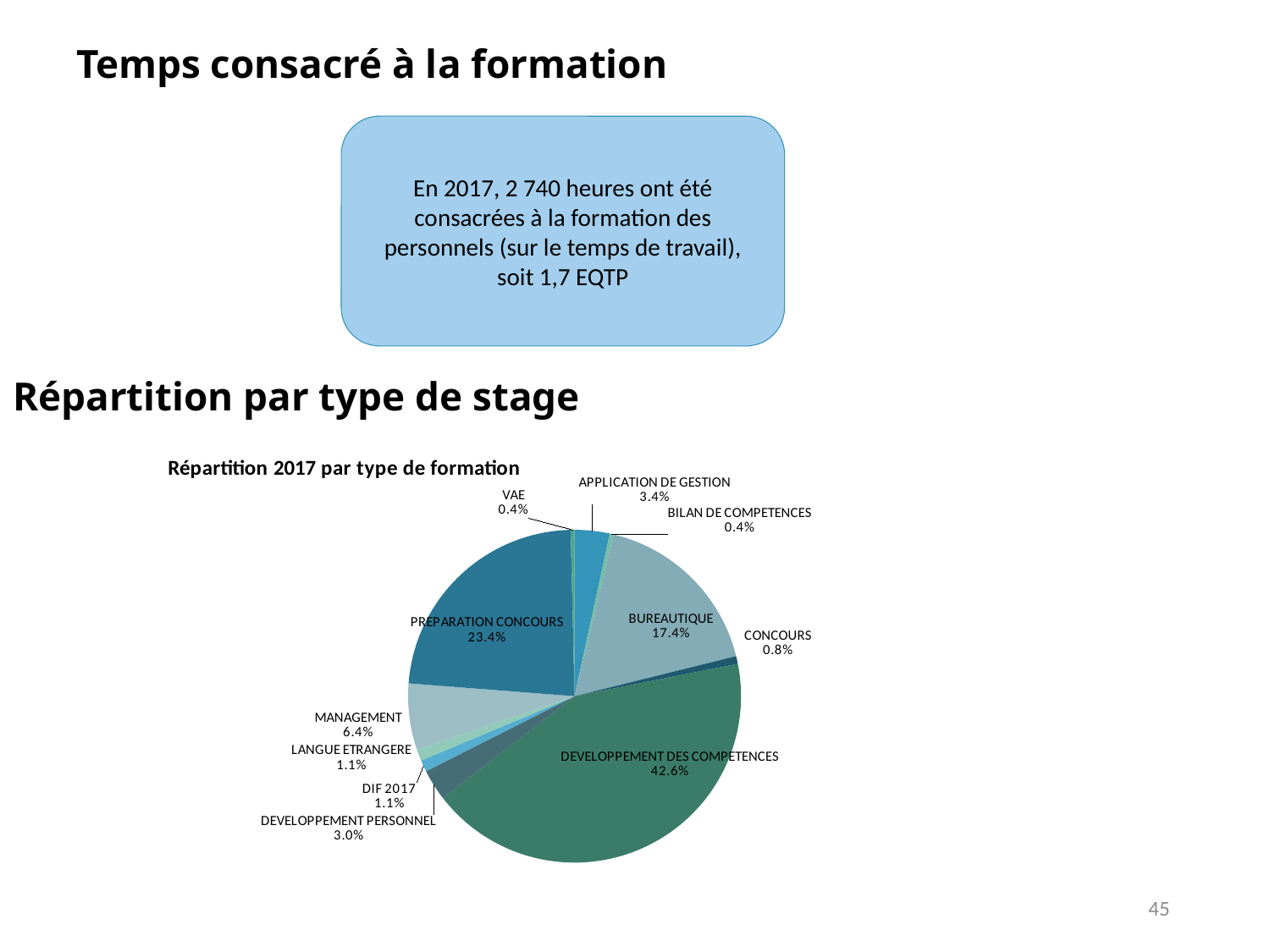
What is the value shown for PREPARATION CONCOURS? 23.4% What is the title of the chart? Répartition 2017 par type de formation What is the value shown for APPLICATION DE GESTION? 3.4% Which category has the largest slice of the pie? DEVELOPPEMENT DES COMPETENCES What is the value shown for BUREAUTIQUE? 17.4% What is the difference between the shares of PREPARATION CONCOURS and BUREAUTIQUE? 6.0% What type of chart is shown on the slide? pie chart What is the value shown for CONCOURS? 0.8% What is the value shown for MANAGEMENT? 6.4% How many slices does the pie chart have? 11 Which is larger, the share for MANAGEMENT or the share for DEVELOPPEMENT PERSONNEL? MANAGEMENT What share of the pie does DEVELOPPEMENT DES COMPETENCES represent? 42.6%